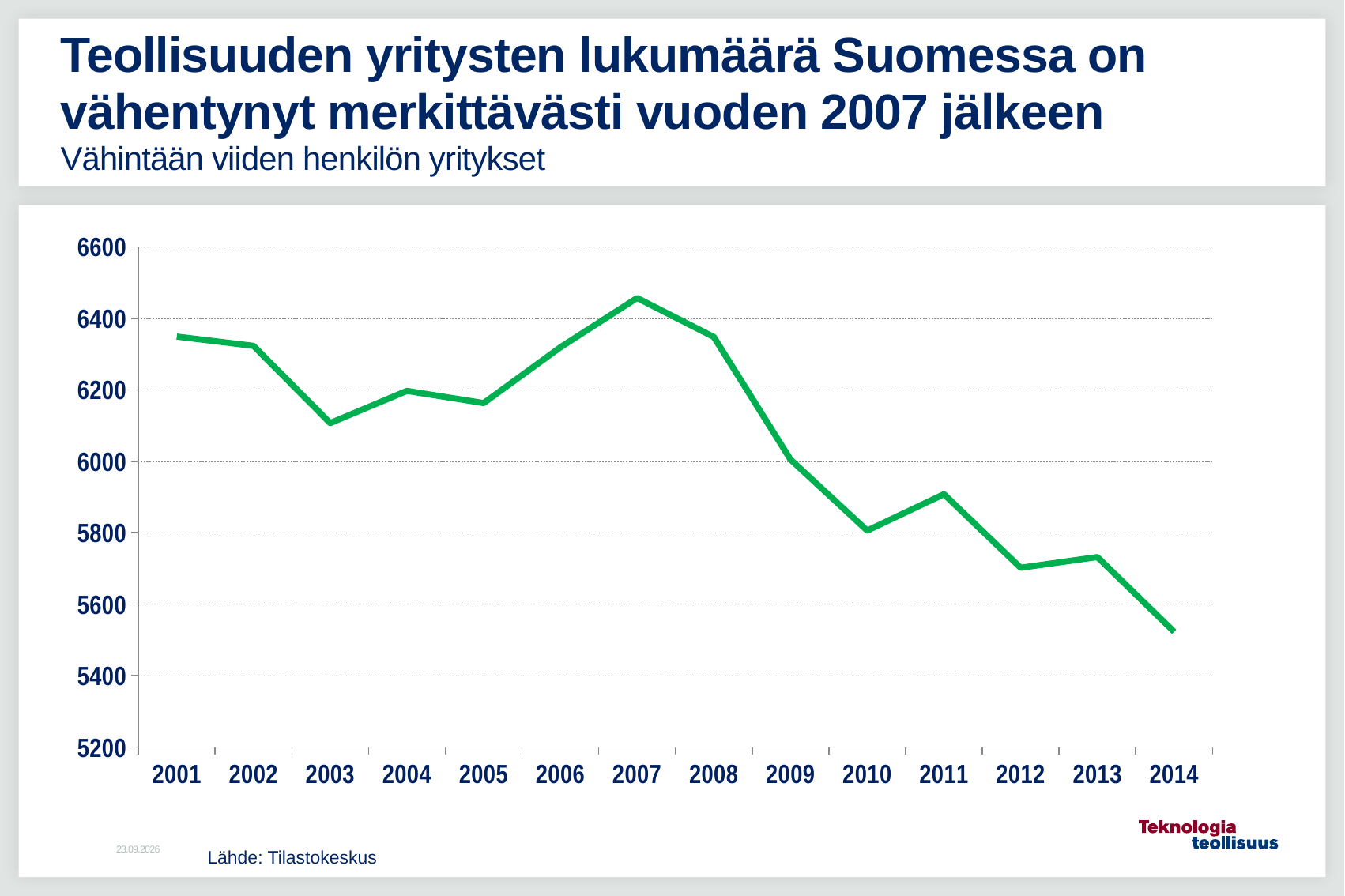
Does the number of companies generally rise or fall from 2007 to 2014? fall Is the value for 2003 greater or less than 6200? less In which year is the number of industrial companies lowest? 2014 Is the value for 2010 greater or less than 6000? less Is the value for 2014 greater or less than 5600? less In which year is the number of industrial companies highest? 2007 Which year has the larger value, 2006 or 2003? 2006 What source is cited for the chart data? Tilastokeskus What kind of chart is shown on the slide? line chart How many years are plotted on the x axis? 14